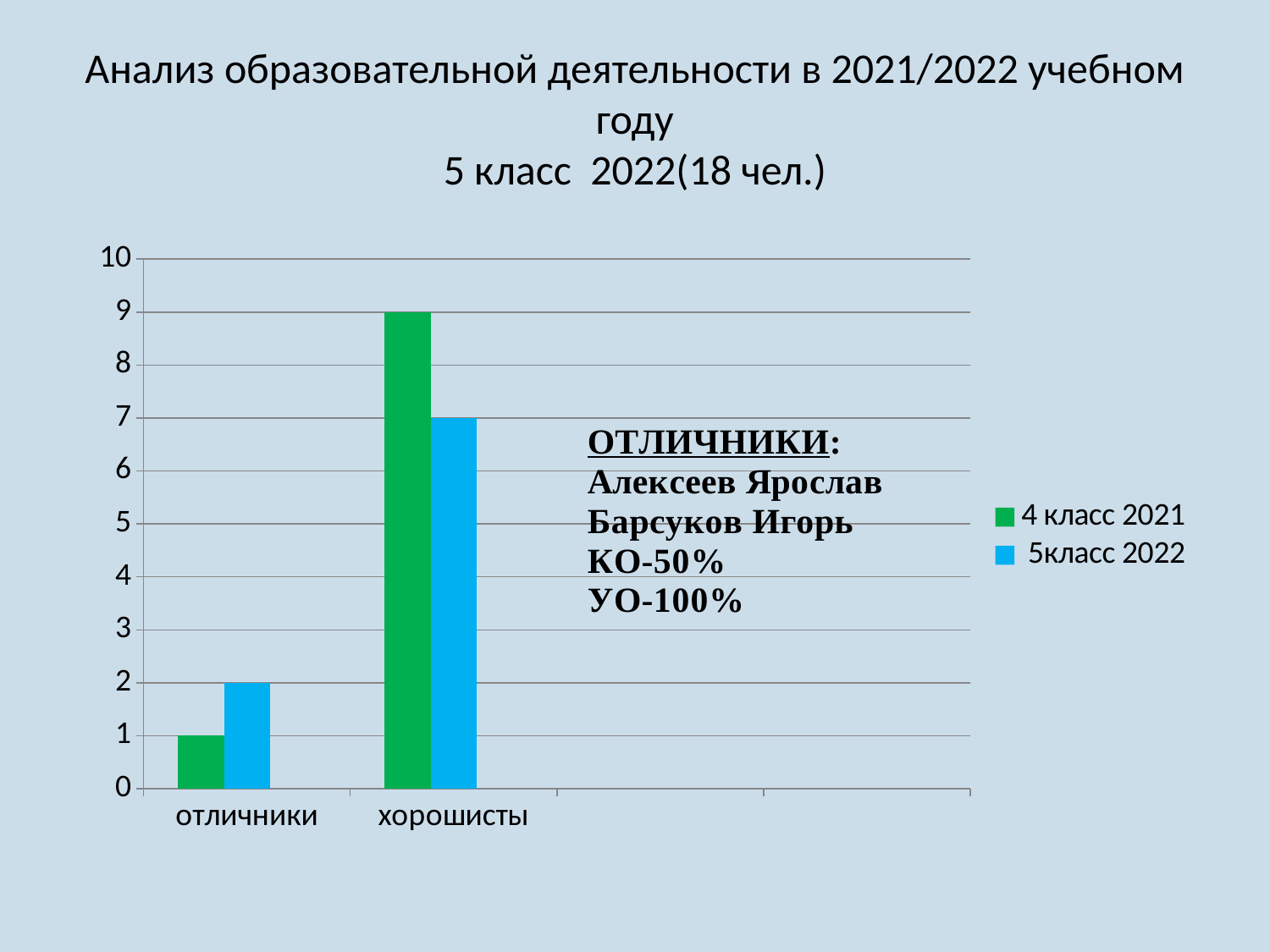
Which colour represents the 5класс 2022 series in the legend? blue What is the value for отличники in the 5класс 2022 series? 2 What is the value for отличники in the 4 класс 2021 series? 1 How many categories are shown on the x axis? 2 What is the value for хорошисты in the 4 класс 2021 series? 9 Which category has the lowest value in the 5класс 2022 series? отличники Which category has the highest value in the 4 класс 2021 series? хорошисты What is the value for хорошисты in the 5класс 2022 series? 7 What kind of chart is shown on the slide? bar chart For отличники, which series has the larger value: 4 класс 2021 or 5класс 2022? 5класс 2022 How many series does the legend list? 2 What is the difference between the 4 класс 2021 and 5класс 2022 values for хорошисты? 2